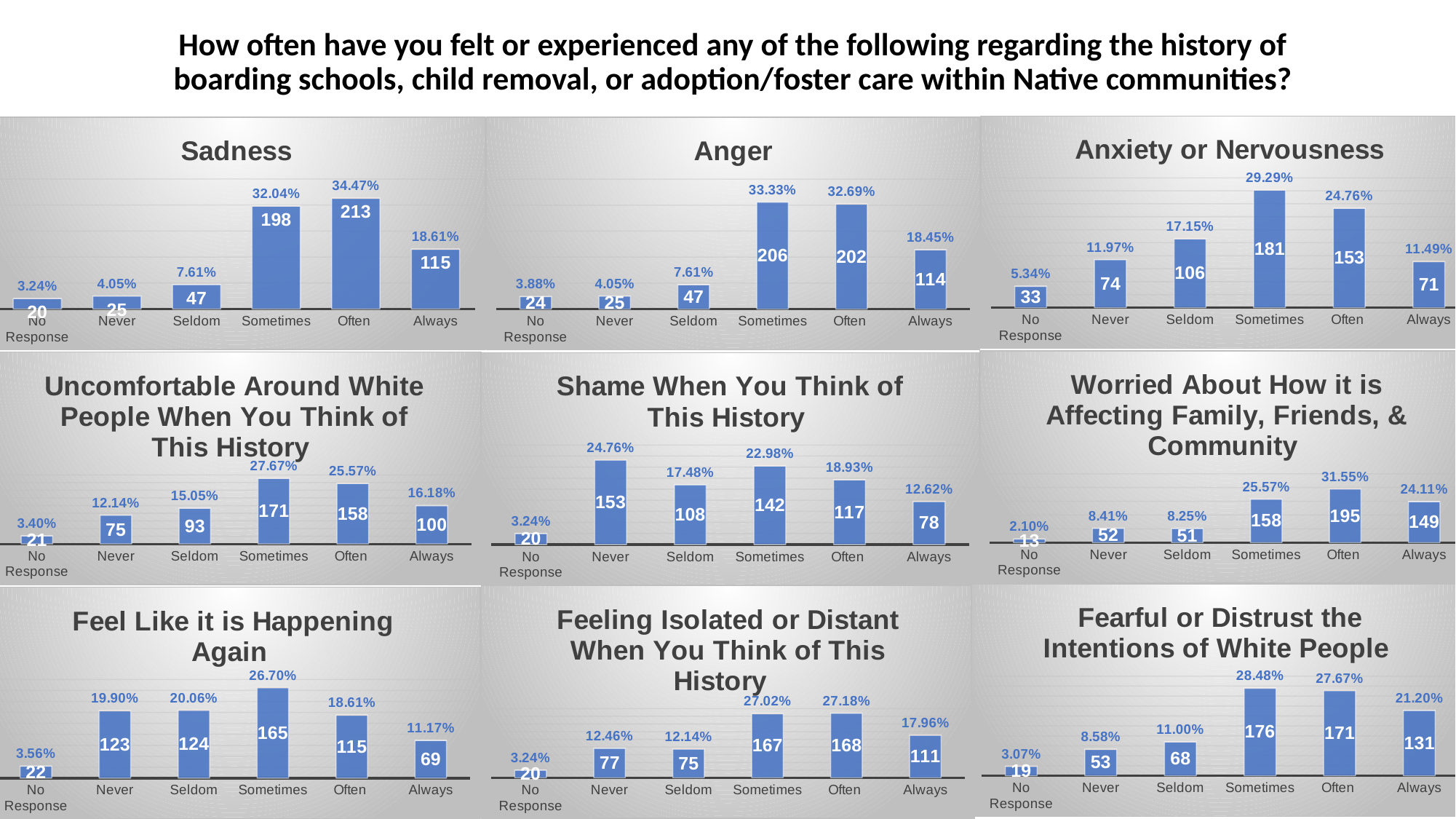
In the Uncomfortable Around White People When You Think of This History chart, how many respondents answered Seldom? 93 In the Fearful or Distrust the Intentions of White People chart, which is larger: the count for Sometimes or the count for Always? Sometimes In the Anger chart, what percentage of respondents answered Sometimes? 33.33% In the Sadness chart, how many respondents answered Often? 213 In the Anxiety or Nervousness chart, which response category has the highest count? Sometimes In the Sadness chart, what is the difference between the Often count and the Sometimes count? 15 In the Feel Like it is Happening Again chart, what percentage of respondents answered Sometimes? 26.70% In the Worried About How it is Affecting Family, Friends, & Community chart, which response category has the lowest count? No Response In the Shame When You Think of This History chart, what is the difference between the Never count and the Always count? 75 How many response categories are shown in the Feeling Isolated or Distant When You Think of This History chart? 6 How many charts are shown on the slide? 9 What type of chart is used for Uncomfortable Around White People When You Think of This History? Bar chart